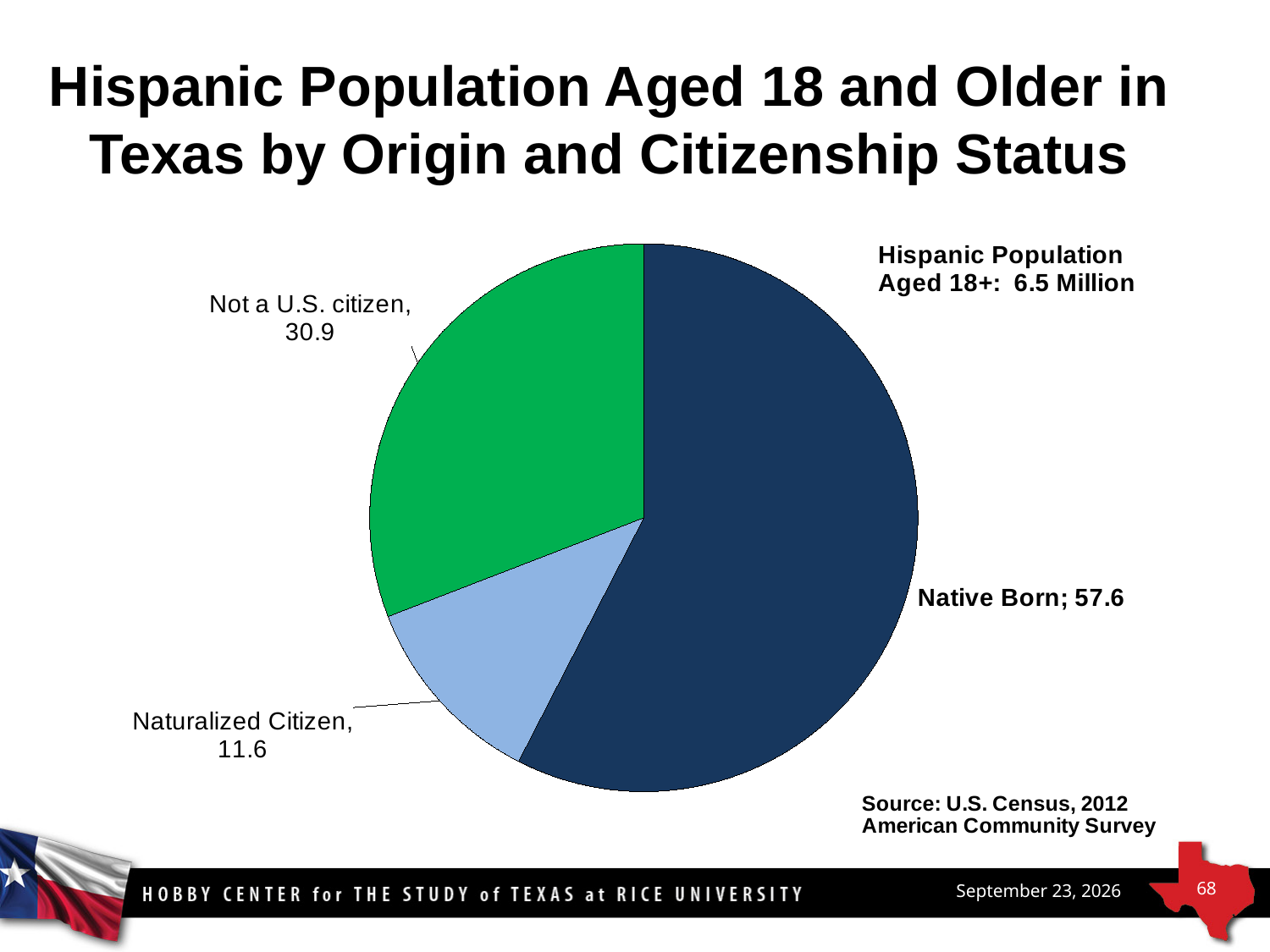
Which category has the smallest slice of the pie? Naturalized Citizen Which category has the largest slice of the pie? Native Born Which is larger, the value for Not a U.S. citizen or the value for Naturalized Citizen? Not a U.S. citizen What value is shown for Native Born? 57.6 What kind of chart is shown on the slide? Pie chart What colour is the Native Born slice? Dark blue What is the difference between the values for Not a U.S. citizen and Naturalized Citizen? 19.3 What value is shown for Not a U.S. citizen? 30.9 What is the difference between the values for Native Born and Not a U.S. citizen? 26.7 What is the total Hispanic population aged 18+ stated on the slide? 6.5 Million How many categories are shown in the pie chart? 3 What value is shown for Naturalized Citizen? 11.6